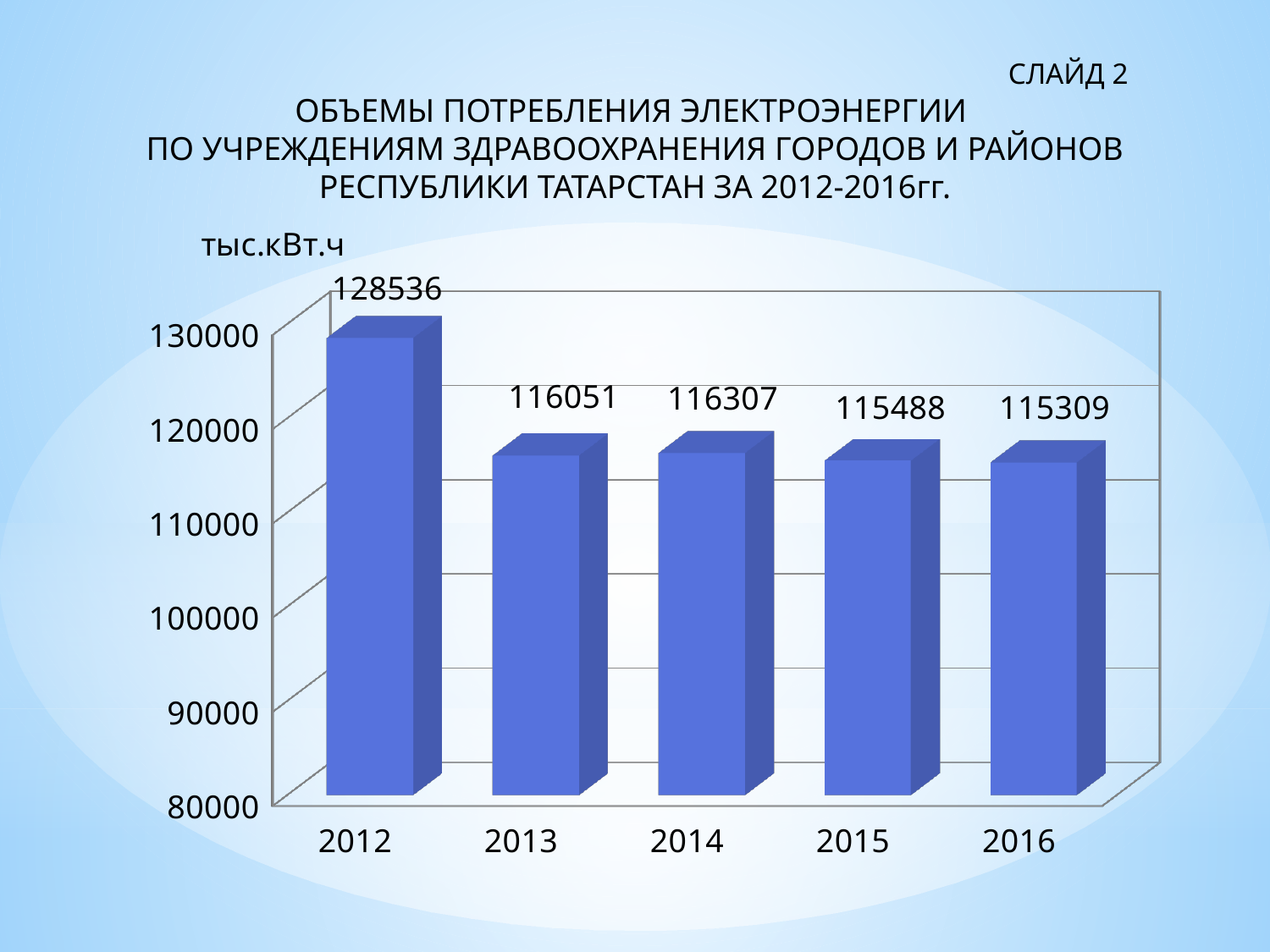
Is the value for 2012 greater or less than 120000? greater What is the value shown for 2016? 115309 What is the value shown for 2015? 115488 What is the electricity consumption value shown for 2012? 128536 Which year has the highest electricity consumption? 2012 Which year has the lowest electricity consumption? 2016 What is the difference between the values for 2012 and 2013? 12485 What kind of chart is shown on the slide? bar chart What is the difference between the values for 2014 and 2013? 256 Which year has the larger value, 2013 or 2014? 2014 How many years are shown on the x axis? 5 What unit of measurement is written above the chart? тыс.кВт.ч